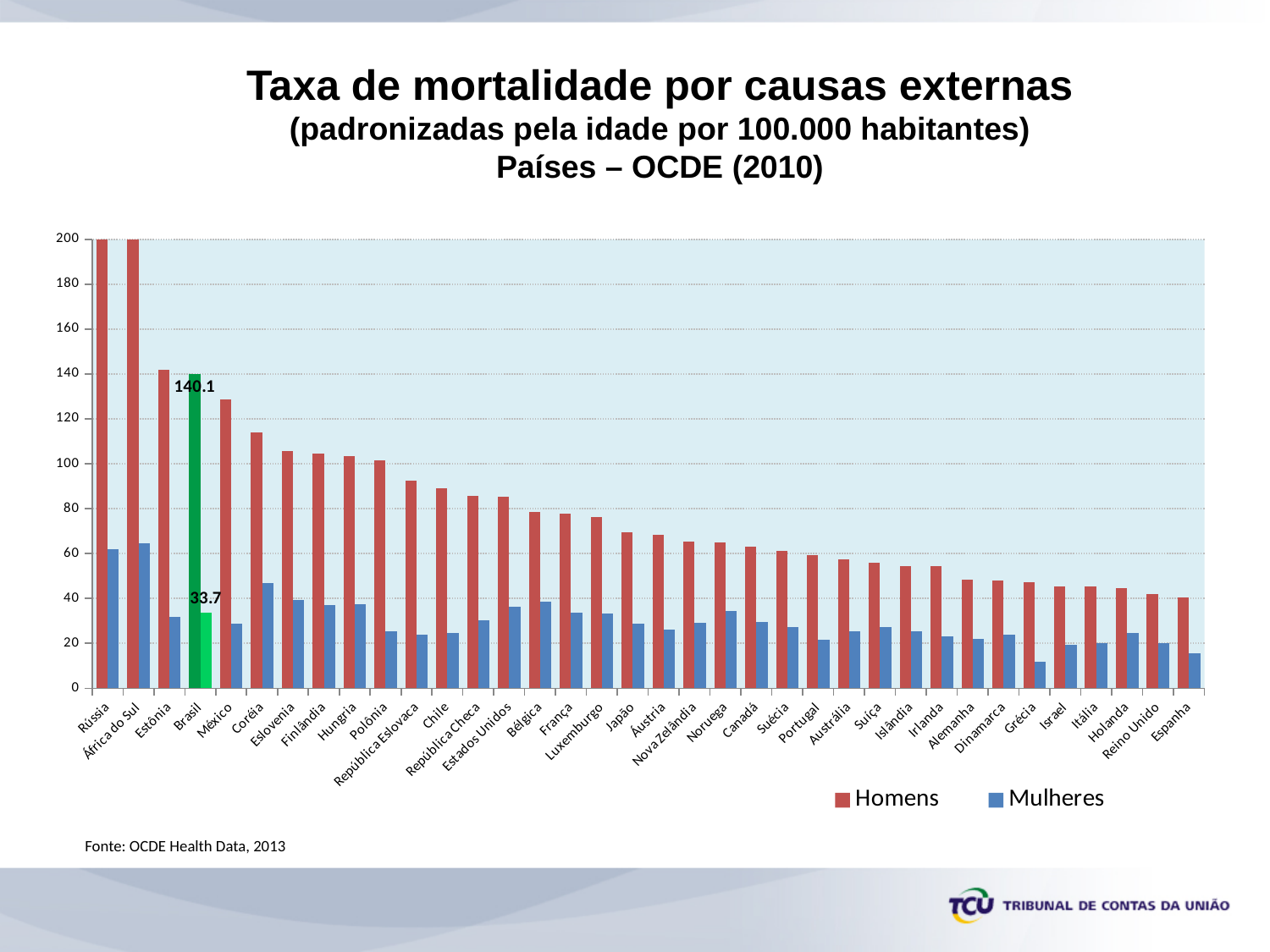
Which is larger, the Homens value for Brasil or the Homens value for México? Brasil Do the Homens values rise or fall moving from left to right along the x axis? Fall What kind of chart is shown on the slide? Bar chart What colour are the bars for Brasil? Green What is the value for Homens in Brasil? 140.1 Is the Mulheres value for Grécia greater or less than 20? less What is the value for Mulheres in Brasil? 33.7 How many countries are shown on the x axis? 36 What is the difference between the Homens and Mulheres values for Brasil? 106.4 Is the Homens value for Estônia greater or less than 120? greater How many series does the legend list? 2 Which country has the lowest Mulheres value? Grécia